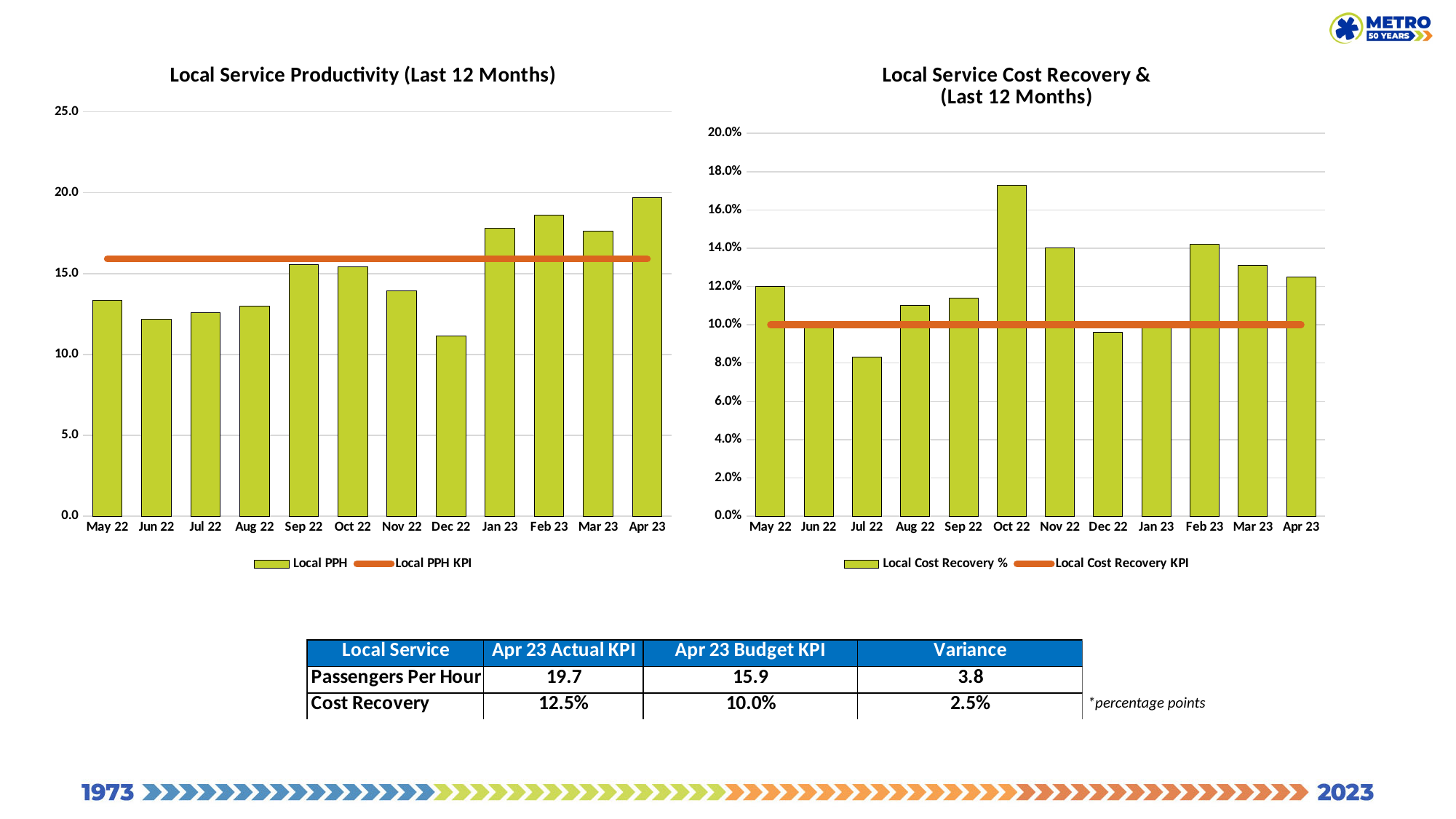
How many series does the legend of the Local Service Cost Recovery chart list? 2 On the Local Service Cost Recovery chart, which is larger, the Local Cost Recovery % for Oct 22 or for Nov 22? Oct 22 What are the two legend entries on the Local Service Productivity (Last 12 Months) chart? Local PPH and Local PPH KPI What kind of chart is the Local Service Productivity (Last 12 Months) chart? bar chart How many months are plotted on the Local Service Productivity (Last 12 Months) chart? 12 On the Local Service Productivity (Last 12 Months) chart, is the Local PPH value for Dec 22 greater or less than 15.0? less On the Local Service Cost Recovery chart, which month has the lowest Local Cost Recovery % bar? Jul 22 On the Local Service Cost Recovery chart, is the Local Cost Recovery % for Jul 22 greater or less than 10.0%? less On the Local Service Productivity (Last 12 Months) chart, what is the Local PPH value for Apr 23? 19.7 On the Local Service Productivity (Last 12 Months) chart, which month has the lowest Local PPH bar? Dec 22 On the Local Service Cost Recovery chart, which month has the highest Local Cost Recovery % bar? Oct 22 On the Local Service Productivity (Last 12 Months) chart, which month has the highest Local PPH bar? Apr 23